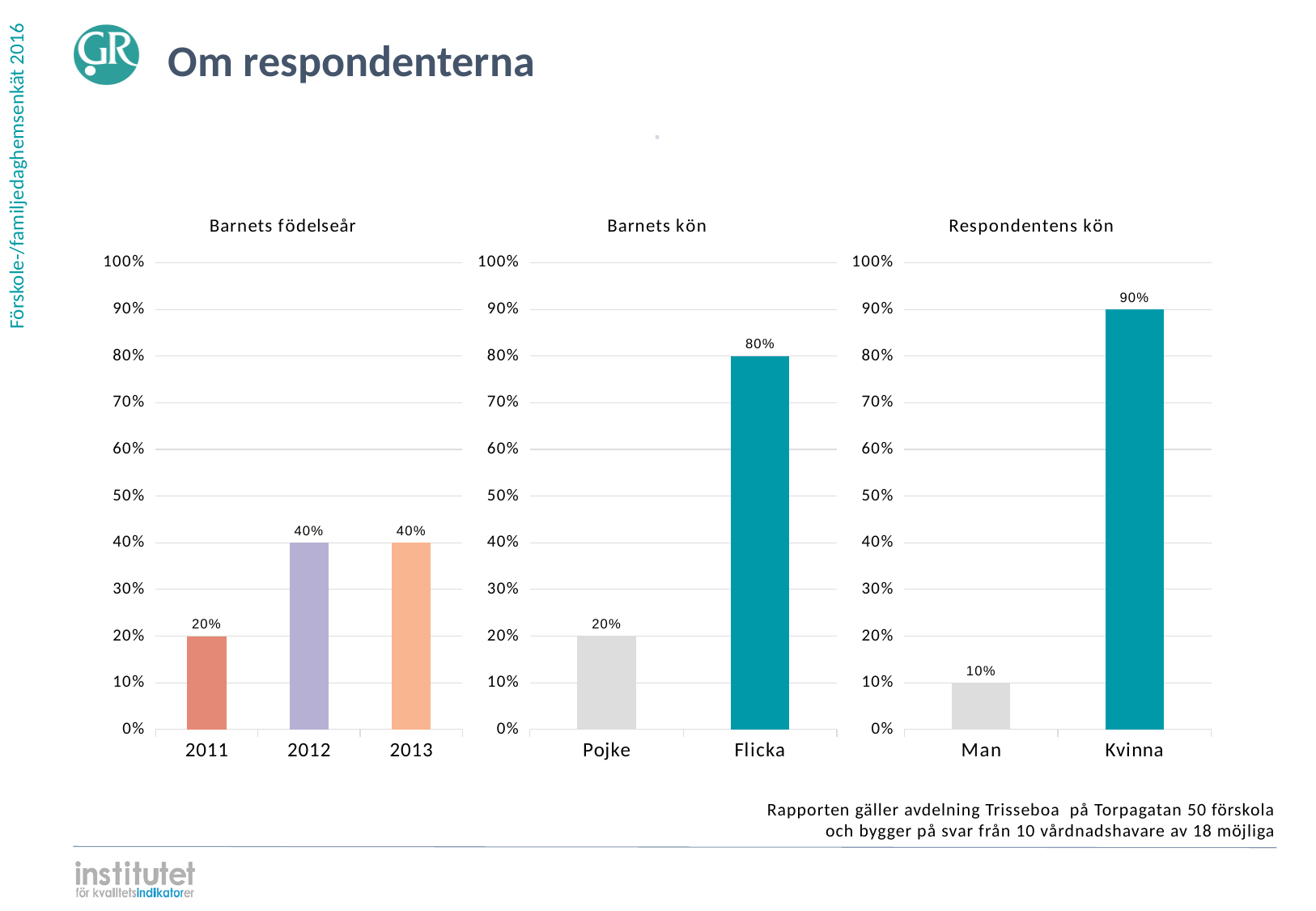
In the 'Barnets födelseår' chart, which category has the lowest value? 2011 What kind of chart is the 'Barnets kön' chart? Bar chart In the 'Barnets kön' chart, what is the difference between the values for Flicka and Pojke? 60% In the 'Respondentens kön' chart, what is the value for Man? 10% In the 'Respondentens kön' chart, is the value for Kvinna greater or less than 50%? greater In the 'Barnets födelseår' chart, what is the value for 2011? 20% What is the title of the chart on the left of the slide? Barnets födelseår In the 'Barnets kön' chart, what is the value for Flicka? 80% In the 'Respondentens kön' chart, which is larger, the value for Man or the value for Kvinna? Kvinna In the 'Barnets kön' chart, which category has the highest value? Flicka In the 'Barnets födelseår' chart, what is the difference between the values for 2012 and 2011? 20% In the 'Barnets födelseår' chart, how many categories are shown on the x axis? 3